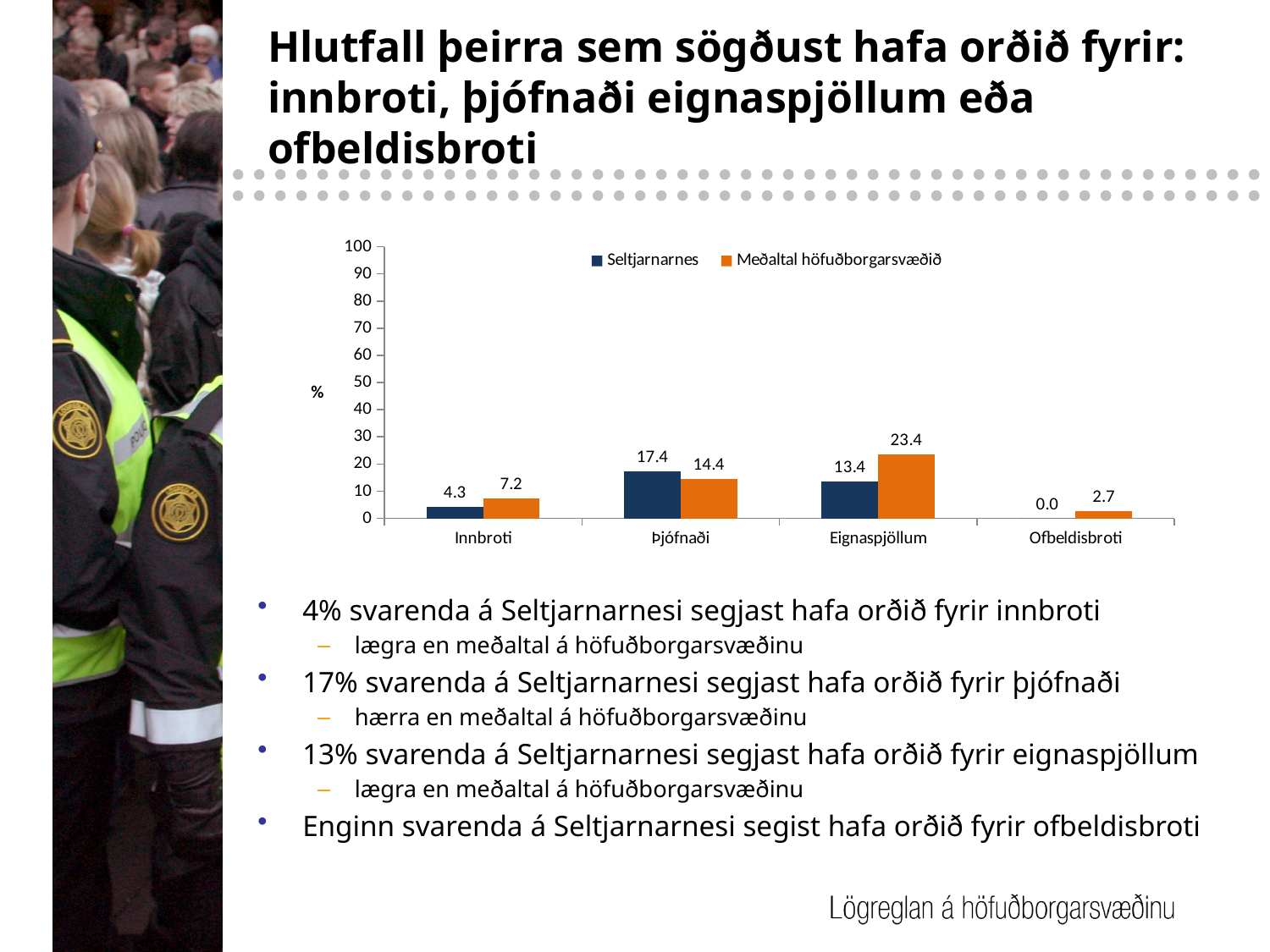
What label is shown on the vertical axis? % In which category is the Seltjarnarnes value highest? Þjófnaði What is the difference between the Meðaltal höfuðborgarsvæðið and Seltjarnarnes values in the Eignaspjöllum category? 10.0 What is the value for Meðaltal höfuðborgarsvæðið in the Þjófnaði category? 14.4 Which is larger in the Þjófnaði category: Seltjarnarnes or Meðaltal höfuðborgarsvæðið? Seltjarnarnes What is the value for Seltjarnarnes in the Innbroti category? 4.3 What kind of chart is shown on the slide? Bar chart How many series does the legend list? 2 How many categories are shown on the x axis? 4 In which category is the Meðaltal höfuðborgarsvæðið value lowest? Ofbeldisbroti What is the value for Seltjarnarnes in the Ofbeldisbroti category? 0.0 What is the value for Meðaltal höfuðborgarsvæðið in the Eignaspjöllum category? 23.4